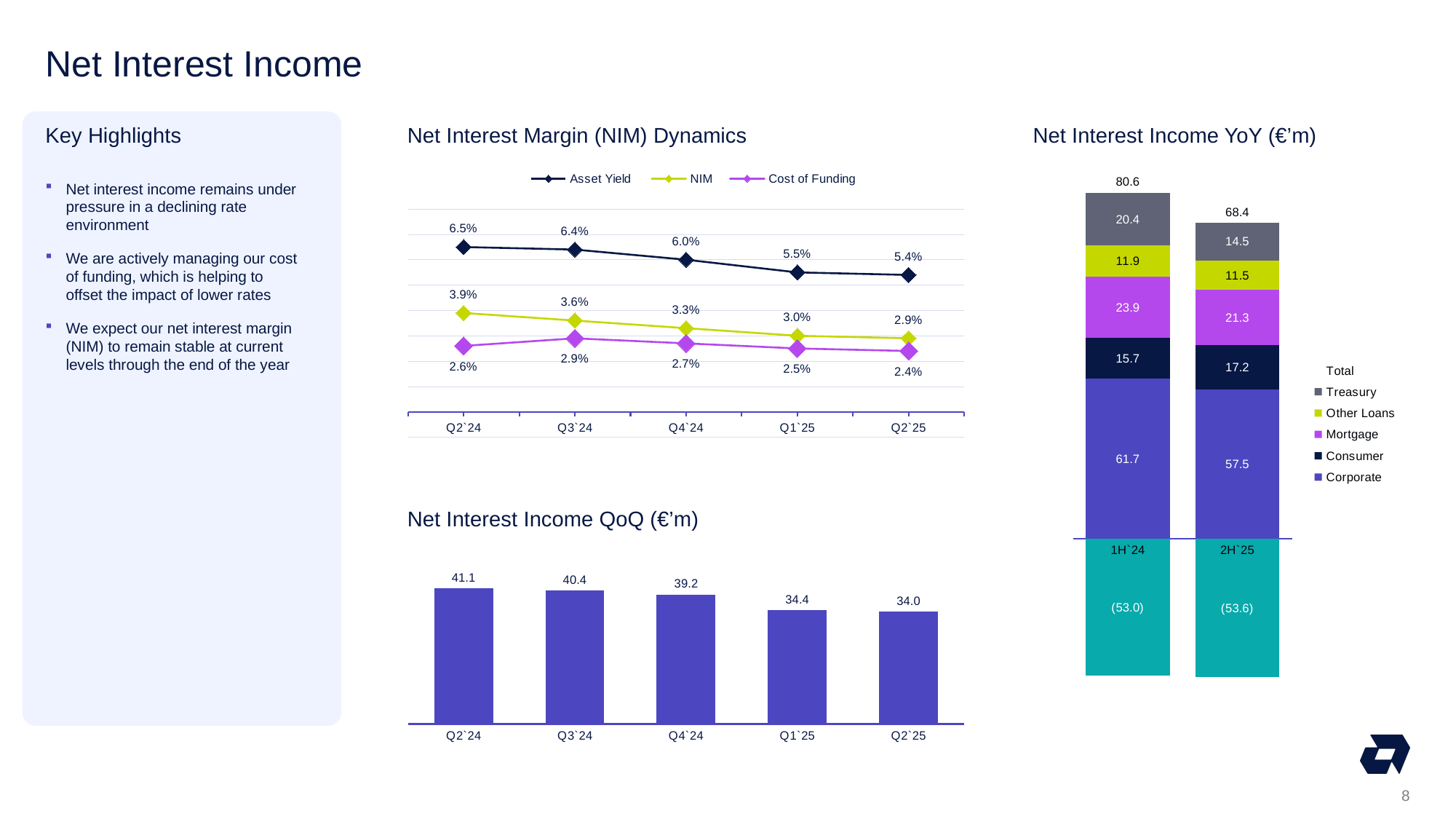
In the Net Interest Income QoQ (€'m) chart, which quarter has the highest value? Q2`24 In the Net Interest Margin (NIM) Dynamics chart, what is the Asset Yield for Q4`24? 6.0% In the Net Interest Margin (NIM) Dynamics chart, what is the Cost of Funding for Q3`24? 2.9% In the Net Interest Income YoY (€'m) chart, what is the Mortgage value for 2H`25? 21.3 In the Net Interest Margin (NIM) Dynamics chart, how many series does the legend list? 3 In the Net Interest Income YoY (€'m) chart, what is the total shown above the 1H`24 bar? 80.6 In the Net Interest Margin (NIM) Dynamics chart, how does NIM change from Q2`24 to Q2`25? It falls In the Net Interest Income QoQ (€'m) chart, what is the difference between Q2`24 and Q2`25? 7.1 What kind of chart is the Net Interest Income QoQ (€'m) chart? Bar chart In the Net Interest Income YoY (€'m) chart, which is larger: Consumer in 1H`24 or Consumer in 2H`25? Consumer in 2H`25 In the Net Interest Margin (NIM) Dynamics chart, what is the difference between NIM in Q2`24 and NIM in Q2`25? 1.0 percentage point In the Net Interest Income QoQ (€'m) chart, what is the value for Q1`25? 34.4